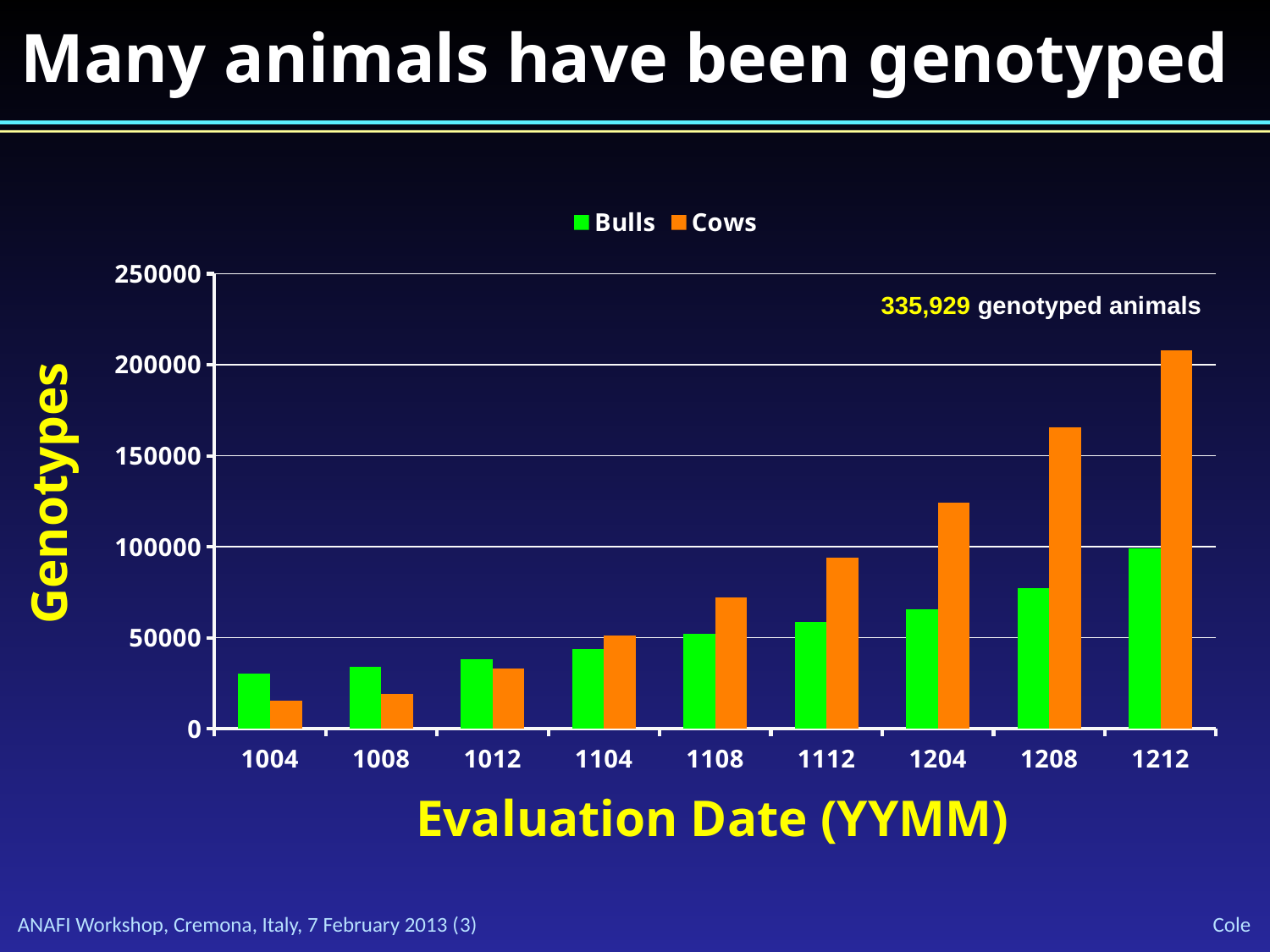
Do the Cows values rise or fall from 1004 to 1212? rise According to the annotation on the chart, how many genotyped animals are there in total? 335,929 At which evaluation date is the Bulls bar highest? 1212 How many evaluation dates are shown on the x axis? 9 Is the value for Bulls at 1204 greater or less than 50000? greater Is the value for Cows at 1212 greater or less than 200000? greater At evaluation date 1004, which series has the larger value, Bulls or Cows? Bulls How many series does the legend list? 2 Is the value for Cows at 1004 greater or less than 50000? less At which evaluation date is the Cows bar highest? 1212 At which evaluation date is the Cows bar lowest? 1004 What kind of chart is shown on the slide? bar chart